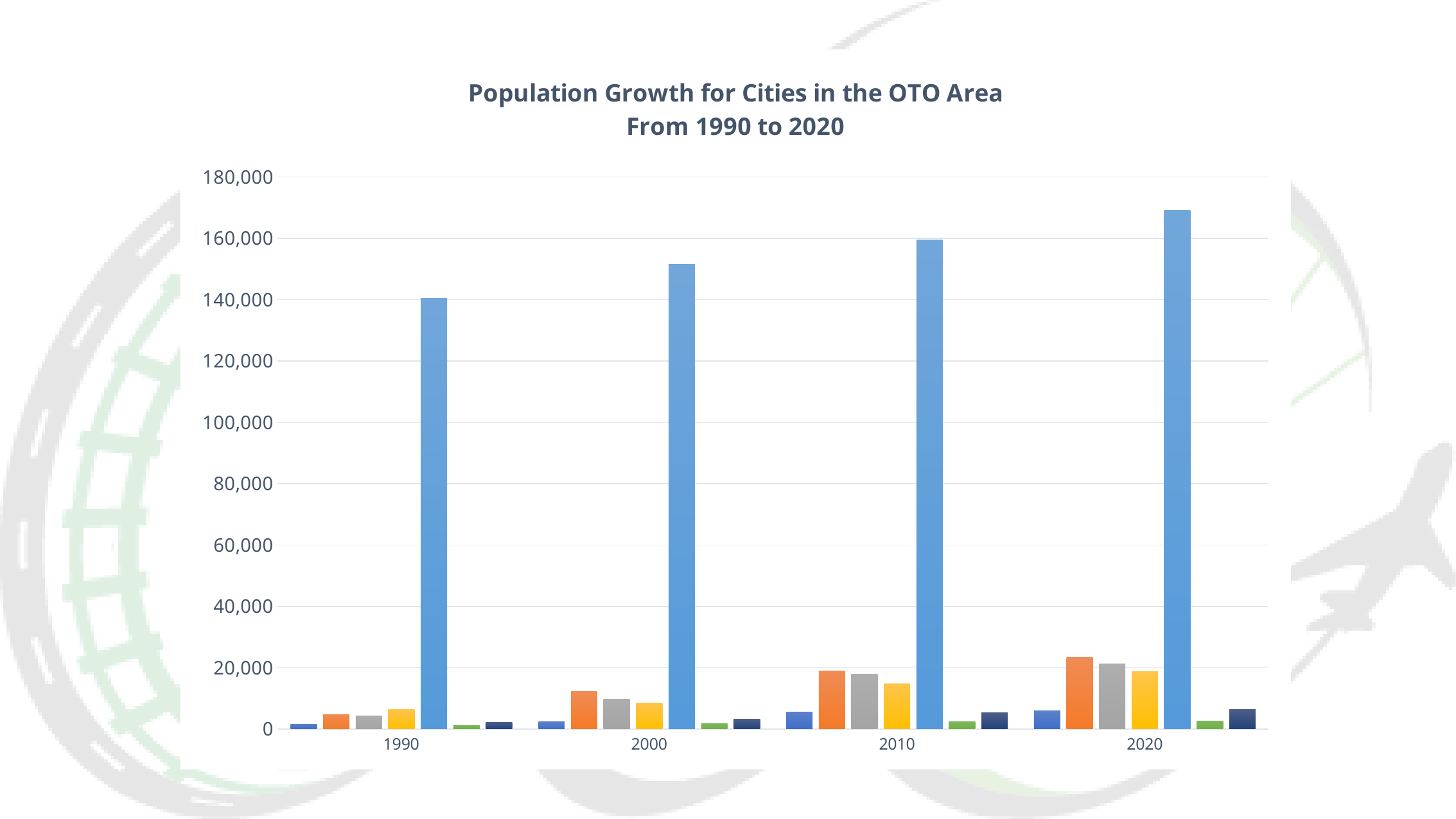
Do the values of the tallest (light blue) series rise or fall from 1990 to 2020? rise Is the tallest (light blue) bar for 2000 greater or less than 160,000? less In which year is the tallest bar on the chart? 2020 What is the title of the chart? Population Growth for Cities in the OTO Area From 1990 to 2020 Which is larger: the tallest bar in 1990 or the tallest bar in 2020? 2020 How many years (categories) are shown on the x axis? 4 What kind of chart is shown on the slide? bar chart Is the tallest (light blue) bar for 2020 greater or less than 160,000? greater Is the tallest (light blue) bar for 2000 greater or less than 140,000? greater Which colour are the tallest bars in every year? light blue